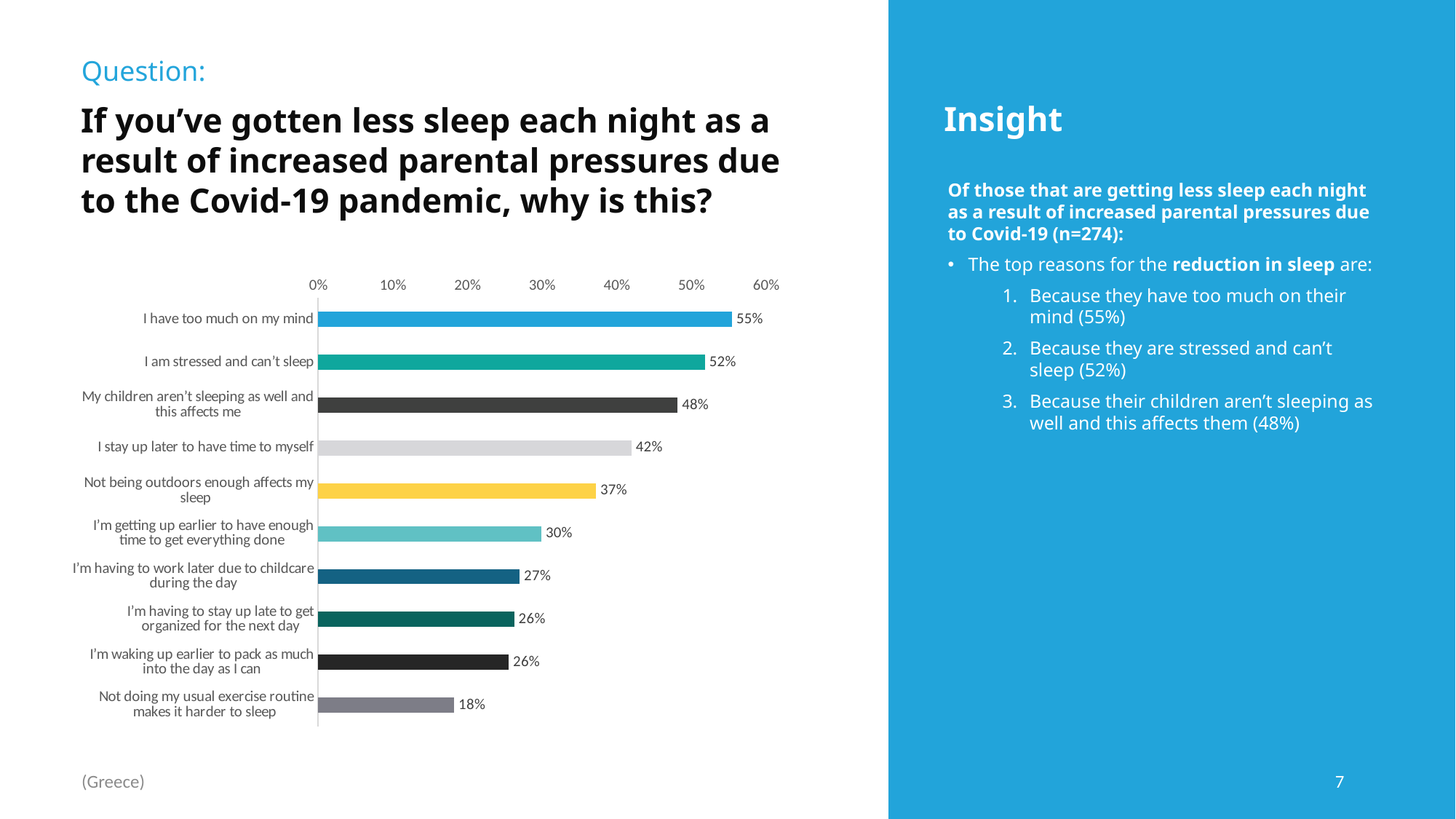
Which reason has the lowest percentage? Not doing my usual exercise routine makes it harder to sleep What percentage of respondents said "I have too much on my mind"? 55% Is the value for "I'm having to stay up late to get organized for the next day" greater or less than 30%? less Which is larger: "I'm getting up earlier to have enough time to get everything done" or "I'm having to work later due to childcare during the day"? I'm getting up earlier to have enough time to get everything done What kind of chart is shown on the slide? Bar chart What is the difference between the highest and lowest values in the chart? 37% What is the value for "I stay up later to have time to myself"? 42% What is the difference between "I am stressed and can't sleep" and "My children aren't sleeping as well and this affects me"? 4% Which reason has the highest percentage? I have too much on my mind What is the maximum value shown on the percentage axis? 60% What percentage is shown for "Not being outdoors enough affects my sleep"? 37% How many reasons are shown in the chart? 10